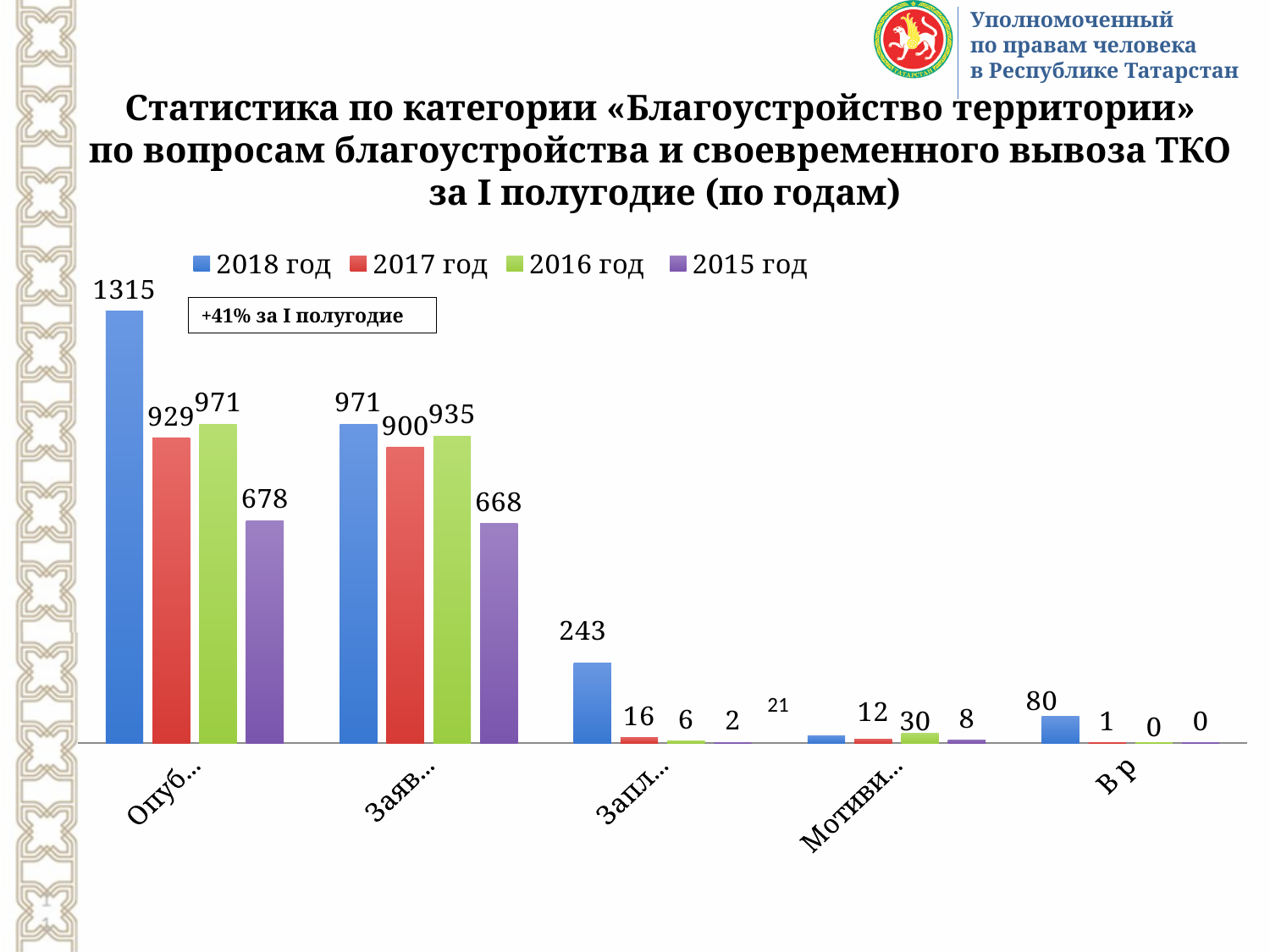
What is the value for 2015 год in the second category from the left (Заяв...)? 668 What text is shown in the boxed annotation near the top of the chart? +41% за I полугодие How many series does the legend list? 4 What is the value for 2018 год in the first category from the left (Опуб...)? 1315 In the first category from the left (Опуб...), which year has the highest value? 2018 год What kind of chart is shown on the slide? bar chart In the first category from the left (Опуб...), which year has the lowest value? 2015 год How many categories are shown along the x axis? 5 What is the difference between the 2018 год and 2017 год values in the first category from the left (Опуб...)? 386 What is the value for 2018 год in the last category on the right (В р)? 80 What is the value for 2018 год in the third category from the left (Запл...)? 243 In the second category from the left (Заяв...), which is larger: the value for 2016 год or for 2017 год? 2016 год